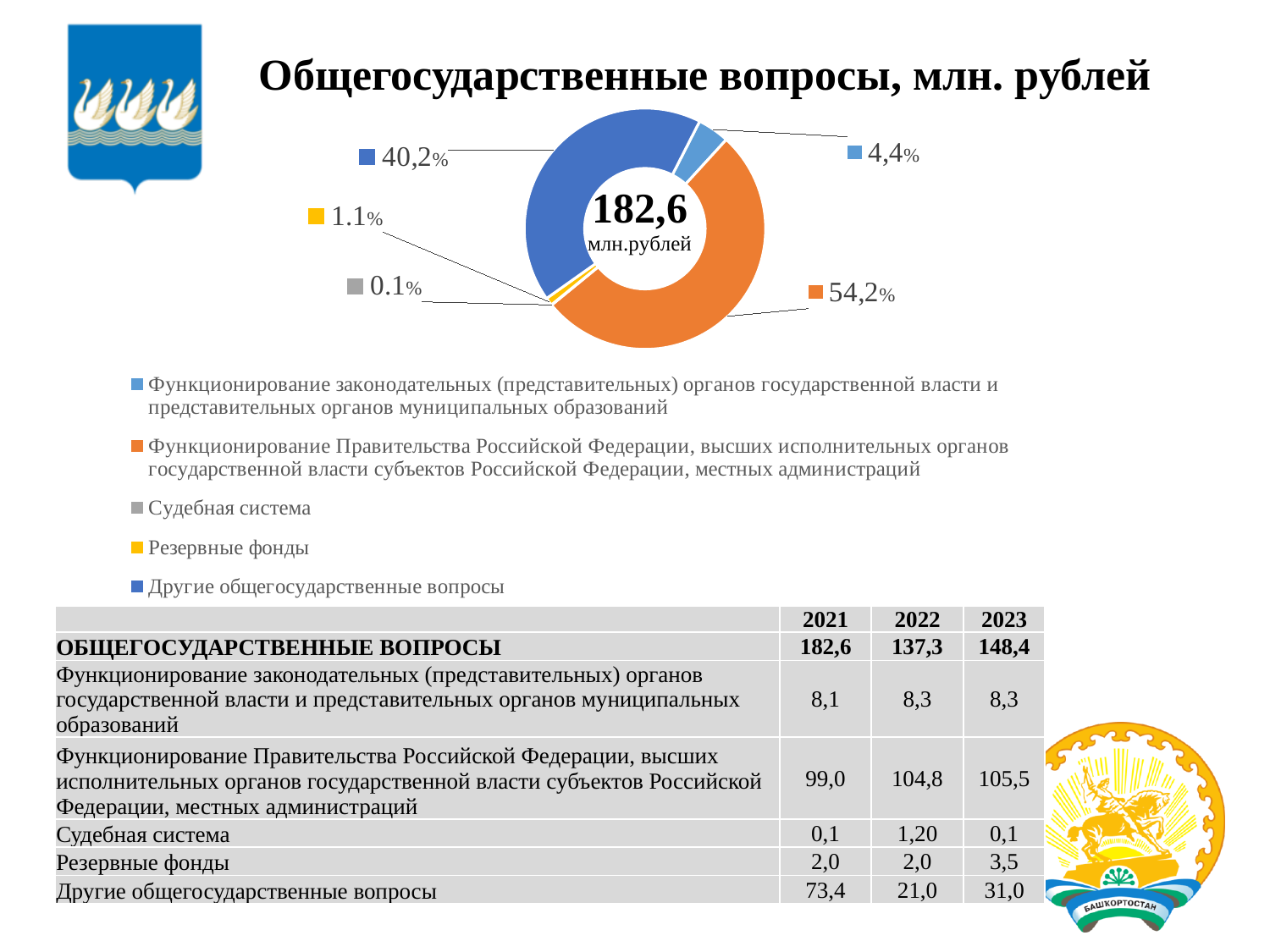
How many categories does the pie chart legend list? 5 Which category has the largest slice in the pie chart? Функционирование Правительства Российской Федерации, высших исполнительных органов государственной власти субъектов Российской Федерации, местных администраций What total value is shown in the centre of the donut chart? 182,6 млн.рублей Which slice is larger: "Резервные фонды" or "Функционирование законодательных (представительных) органов государственной власти и представительных органов муниципальных образований"? Функционирование законодательных (представительных) органов государственной власти и представительных органов муниципальных образований What share of the pie chart does "Судебная система" take? 0.1% What share of the pie chart does "Функционирование Правительства Российской Федерации, высших исполнительных органов государственной власти субъектов Российской Федерации, местных администраций" take? 54,2% What share of the pie chart does "Резервные фонды" take? 1.1% What is the title of the chart? Общегосударственные вопросы, млн. рублей Which category has the smallest slice in the pie chart? Судебная система What kind of chart is shown on the slide? Pie (donut) chart